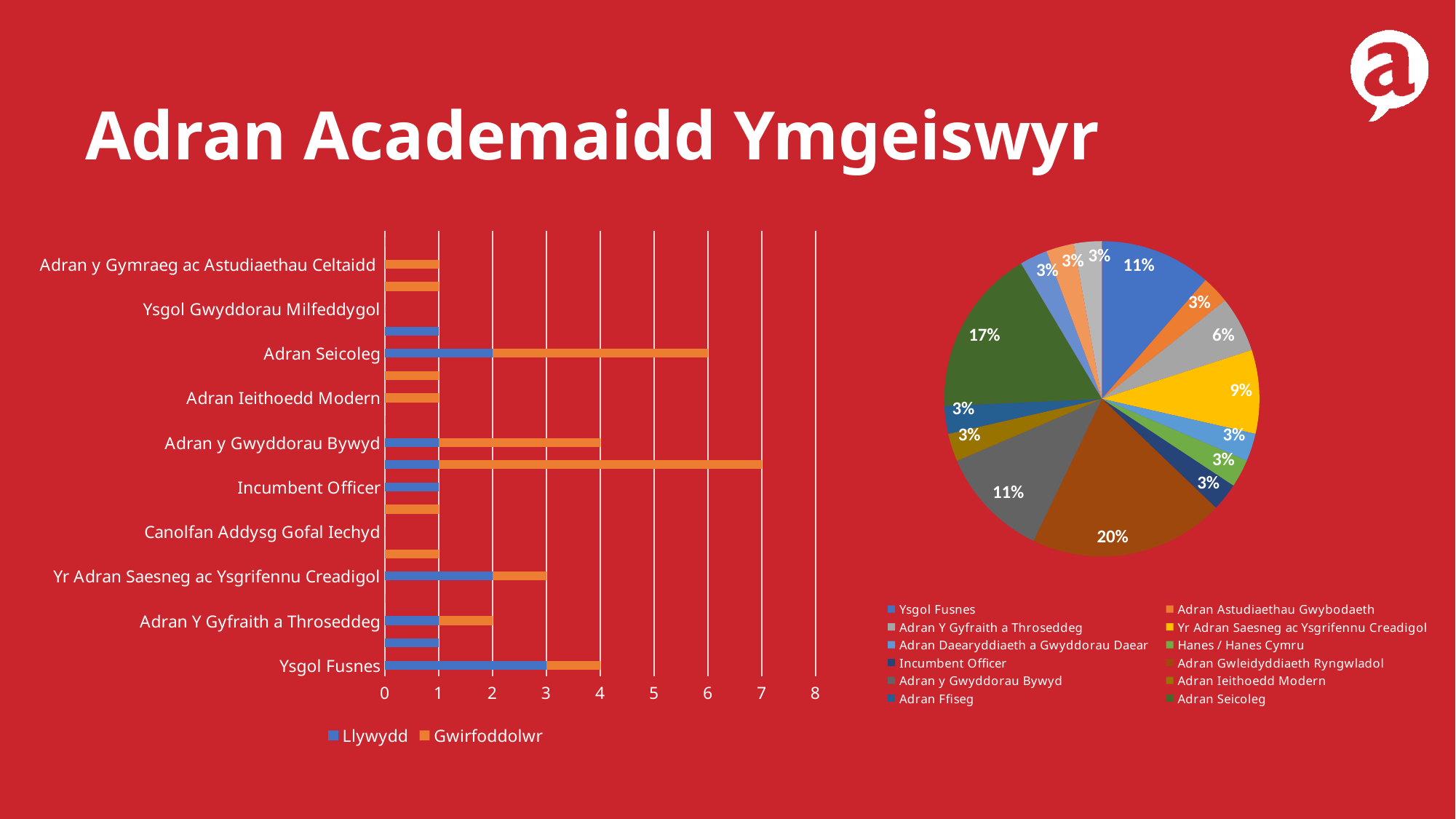
In the bar chart on the left, what are the two series named in the legend? Llywydd and Gwirfoddolwr In the bar chart on the left, what is the Llywydd value for Ysgol Fusnes? 3 In the bar chart on the left, how many series does the legend list? 2 In the bar chart on the left, what is the Llywydd value for Yr Adran Saesneg ac Ysgrifennu Creadigol? 2 In the bar chart on the left, what is the Gwirfoddolwr value for Adran Seicoleg? 4 In the pie chart on the right, how many entries does the legend list? 12 In the bar chart on the left, what is the Gwirfoddolwr value for Adran y Gwyddorau Bywyd? 3 What kind of chart is the chart on the right of the slide? pie chart In the bar chart on the left, which has the larger Llywydd value, Ysgol Fusnes or Adran Seicoleg? Ysgol Fusnes In the pie chart on the right, what share does Ysgol Fusnes have? 11% In the bar chart on the left, what is the total of the stacked bar for Adran Seicoleg? 6 What kind of chart is the chart on the left of the slide? bar chart